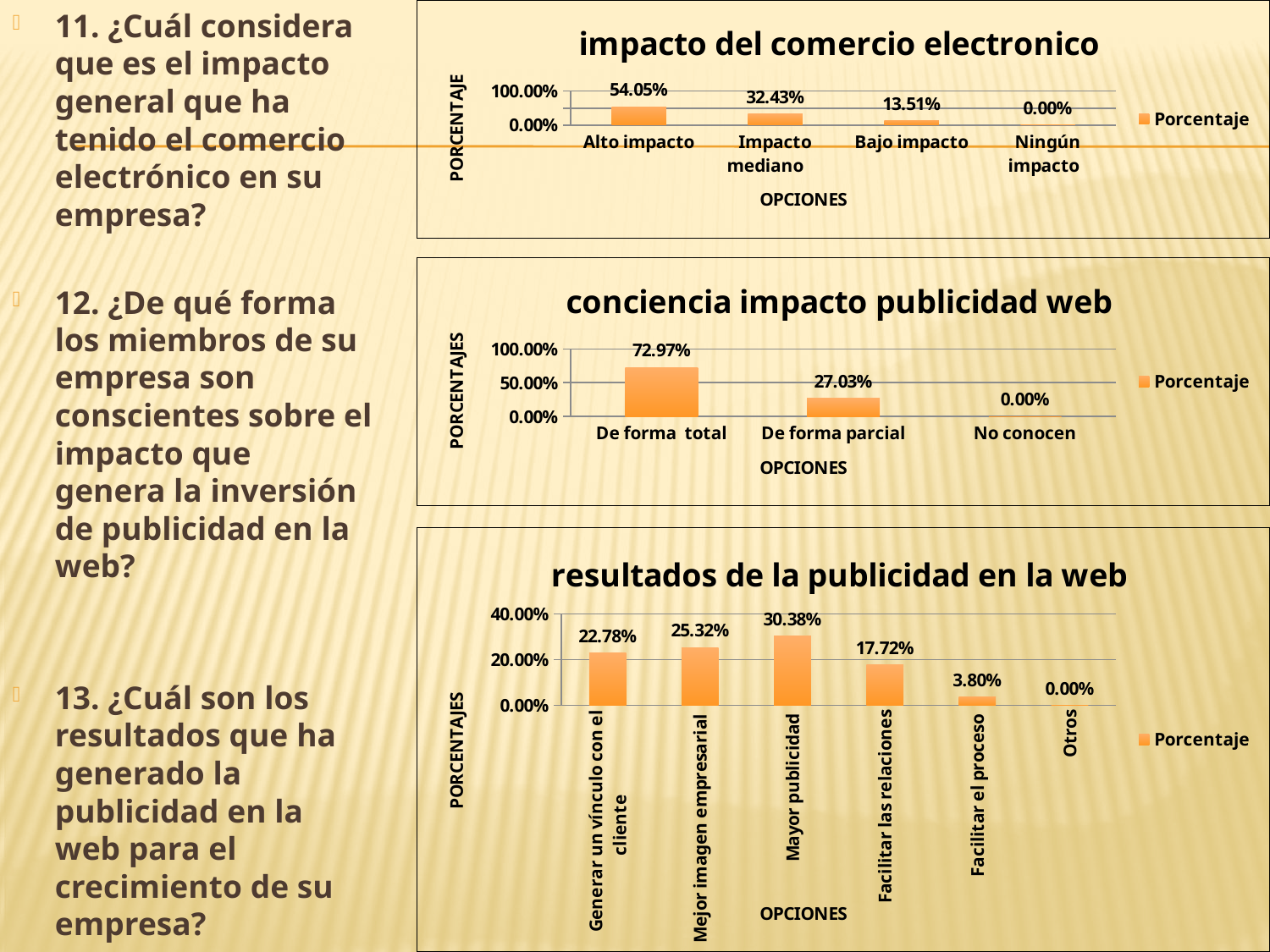
In the chart titled 'resultados de la publicidad en la web', what is the value for 'Facilitar el proceso'? 3.80% In the chart titled 'resultados de la publicidad en la web', which category has the highest value? Mayor publicidad In the chart titled 'conciencia impacto publicidad web', what is the value for 'De forma parcial'? 27.03% In the chart titled 'resultados de la publicidad en la web', how many categories are shown on the x axis? 6 In the chart titled 'resultados de la publicidad en la web', which is larger: 'Generar un vínculo con el cliente' or 'Mejor imagen empresarial'? Mejor imagen empresarial What kind of chart is the chart titled 'resultados de la publicidad en la web'? bar chart In the chart titled 'impacto del comercio electronico', what is the value for 'Alto impacto'? 54.05% In the chart titled 'impacto del comercio electronico', which category has the lowest value? Ningún impacto In the chart titled 'conciencia impacto publicidad web', is the value for 'De forma total' greater or less than 50.00%? greater In the chart titled 'impacto del comercio electronico', how many categories are shown on the x axis? 4 In the chart titled 'conciencia impacto publicidad web', which category has the highest value? De forma total In the chart titled 'impacto del comercio electronico', what is the difference between 'Alto impacto' and 'Impacto mediano'? 21.62%